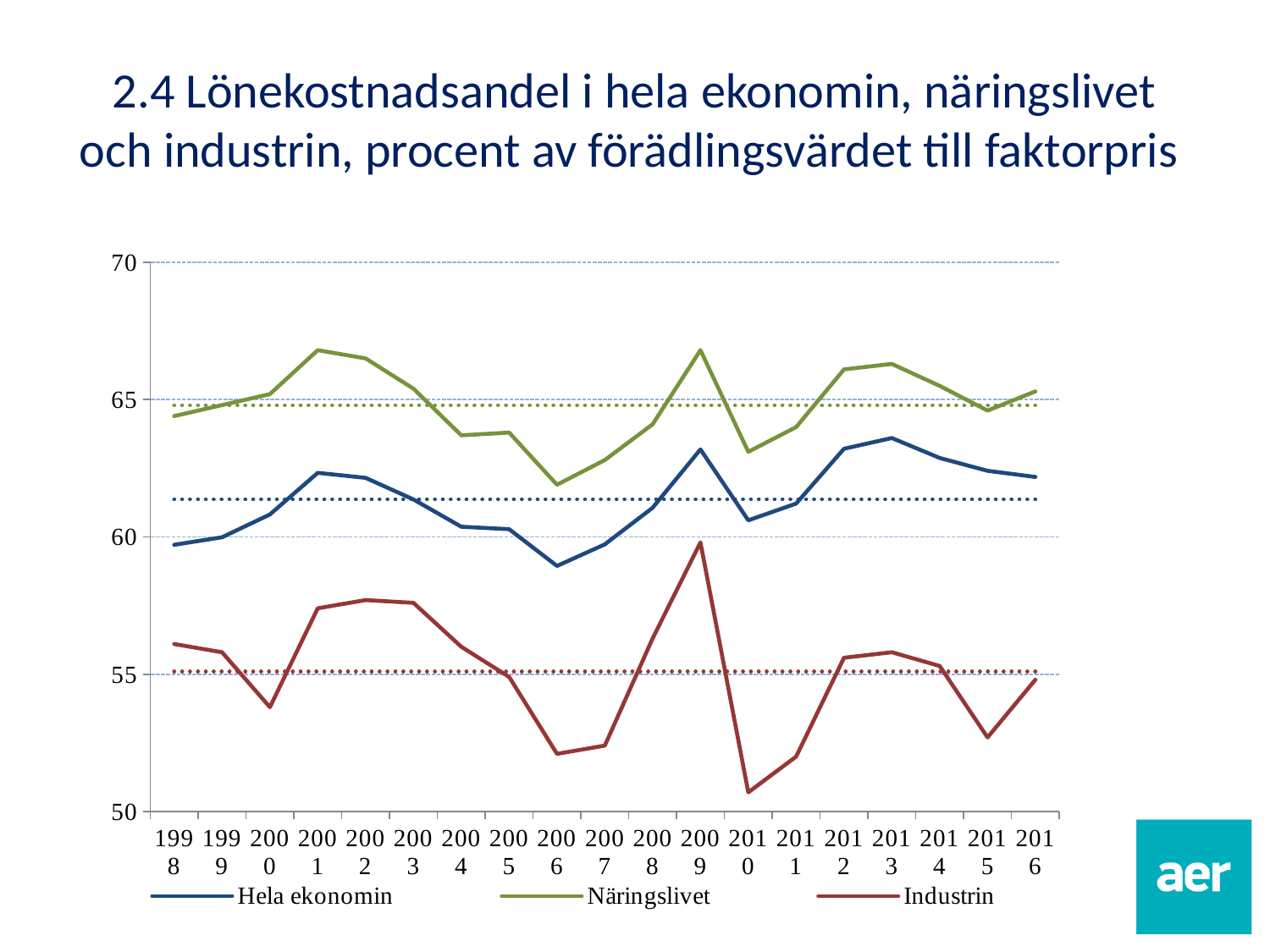
Is the value for Industrin in 2010 greater or less than 55? less How many series does the legend list? 3 How many years are shown on the x axis? 19 Does the Industrin series rise or fall from 2009 to 2010? fall In which year does the Hela ekonomin series reach its lowest value? 2006 In which year does the Industrin series reach its highest value? 2009 In which year does the Industrin series reach its lowest value? 2010 Is the value for Industrin in 2009 greater or less than 55? greater Which series is higher in 2009, Näringslivet or Industrin? Näringslivet What kind of chart is shown on the slide? line chart Is the value for Hela ekonomin in 2006 greater or less than 60? less